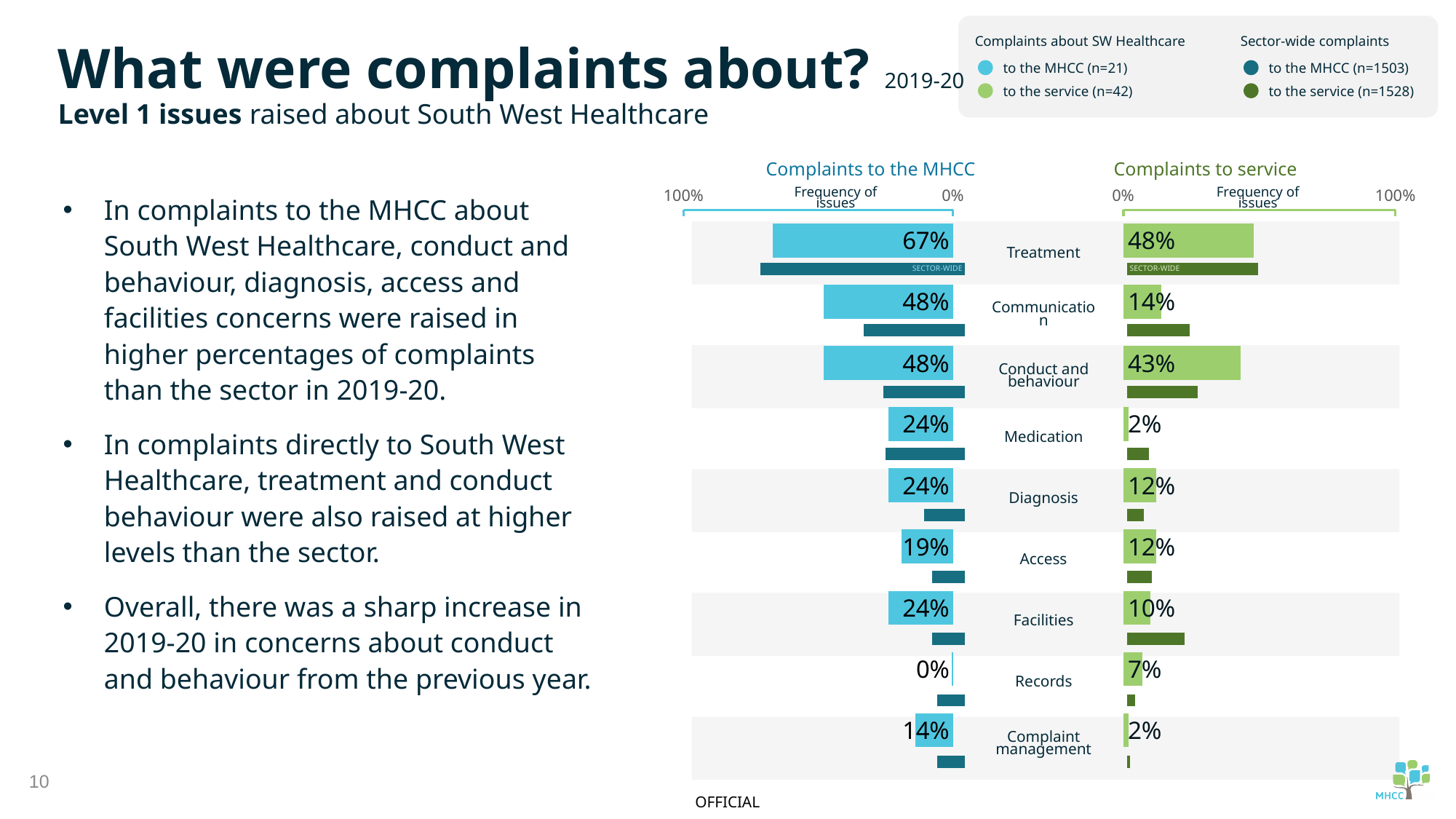
Is the Treatment percentage higher in the Complaints to the MHCC chart or the Complaints to service chart? Complaints to the MHCC In the Complaints to the MHCC chart, which issue has the lowest frequency for South West Healthcare? Records How many issue categories are listed in the chart? 9 What kind of chart is shown on the slide? Bar chart In the Complaints to the MHCC chart, what percentage of complaints raised Access? 19% In the Complaints to the MHCC chart, which issue has the highest frequency for South West Healthcare? Treatment In the Complaints to service chart, what percentage of complaints raised Conduct and behaviour? 43% How many series does the legend at the top right of the slide list? 4 In the Complaints to service chart, what is the difference between the Diagnosis and Medication percentages? 10% In the Complaints to service chart, what is the difference between the Treatment and Communication percentages? 34% In the Complaints to the MHCC chart, what percentage of complaints about South West Healthcare raised Treatment? 67% What is the sample size (n) for complaints about SW Healthcare to the service shown in the legend? n=42